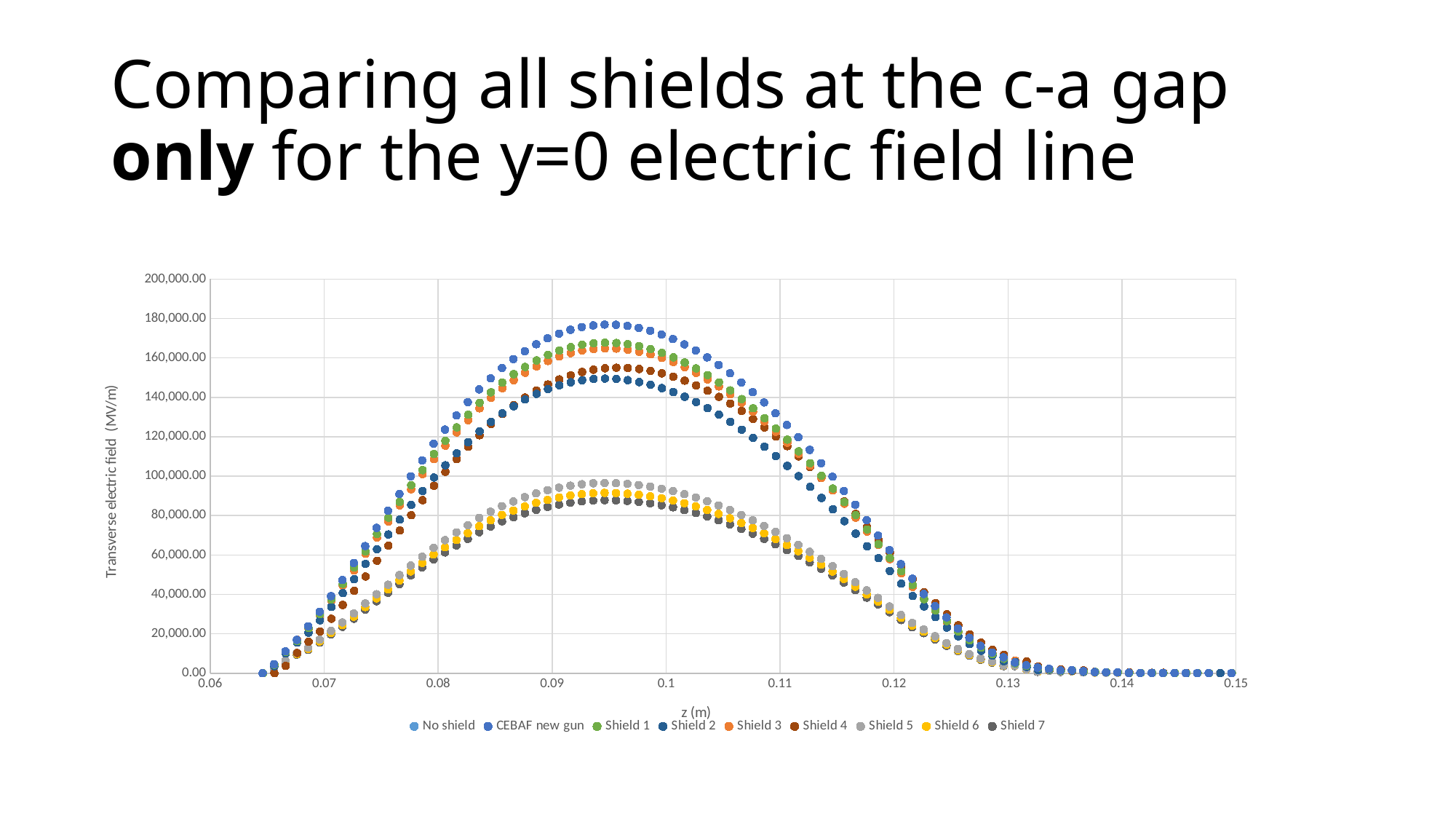
Is the peak value for CEBAF new gun greater or less than 160,000.00? greater What is the title of the y axis? Transverse electric field (MV/m) Is the peak value for Shield 2 greater or less than 140,000.00? greater Is the peak value for Shield 5 greater or less than 100,000.00? less What kind of chart is shown on the slide? scatter chart Which series reaches a higher peak, Shield 5 or Shield 7? Shield 5 Which series reaches a higher peak, Shield 2 or Shield 4? Shield 4 What is the title of the x axis? z (m) How many series does the legend list? 9 How do the values change along the x axis from 0.06 to 0.15? They rise to a peak near 0.095 and then fall back to zero